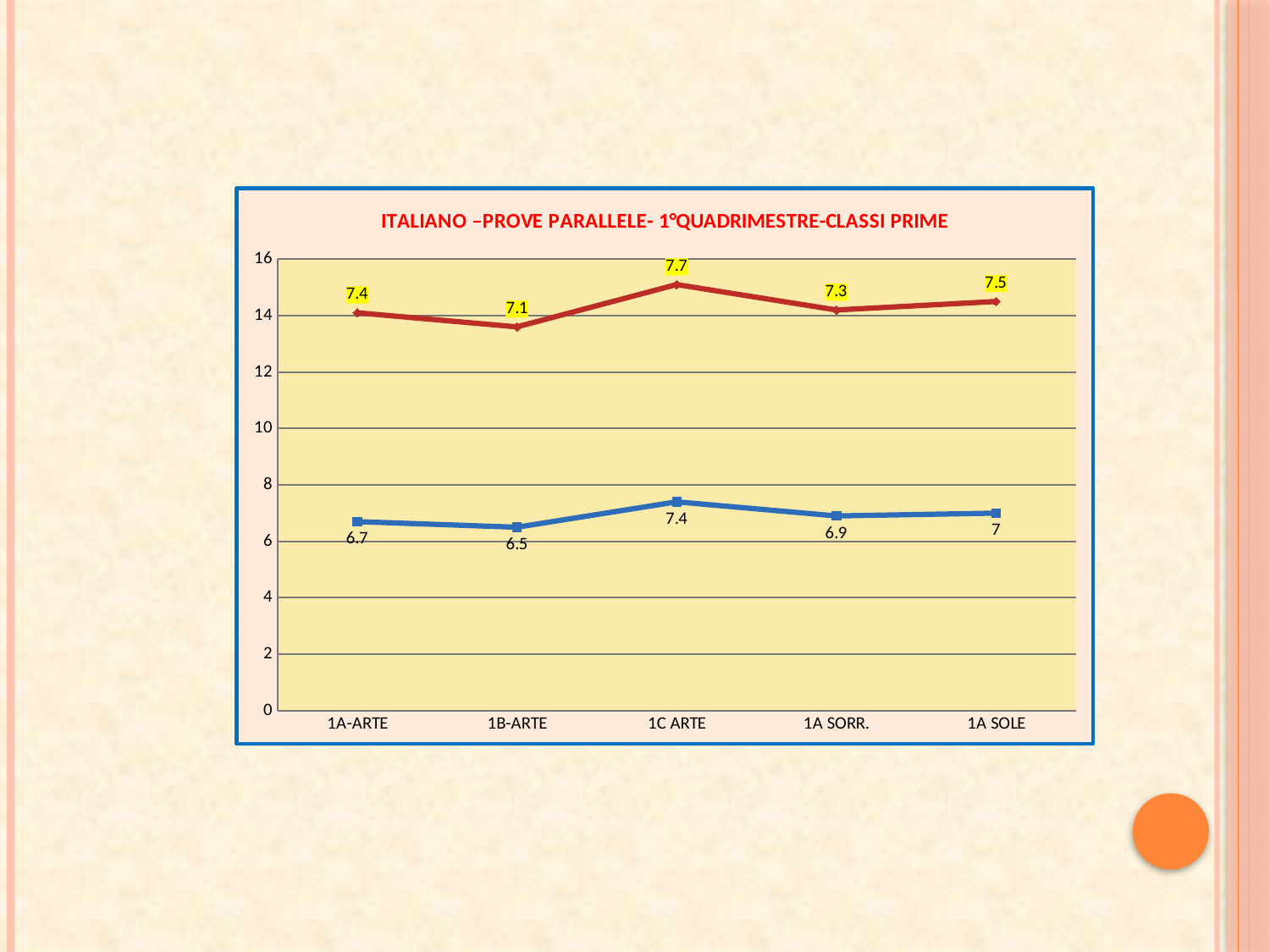
What is the data label on the red line for 1A SORR.? 7.3 What type of chart is shown on the slide? line chart Is the plotted value of the blue line at 1A-ARTE greater or less than 6? greater What is the data label on the blue line for 1A SOLE? 7 Which category has the highest data label on the red line? 1C ARTE How many categories are shown on the x axis of the chart? 5 What is the data label on the blue line for 1B-ARTE? 6.5 For 1A-ARTE, which line has the larger data label, the red line or the blue line? red line What is the difference between the red line's data label and the blue line's data label for 1C ARTE? 0.3 What is the data label on the red line for 1C ARTE? 7.7 What is the title of the chart? ITALIANO –PROVE PARALLELE- 1°QUADRIMESTRE-CLASSI PRIME Which category has the lowest data label on the blue line? 1B-ARTE